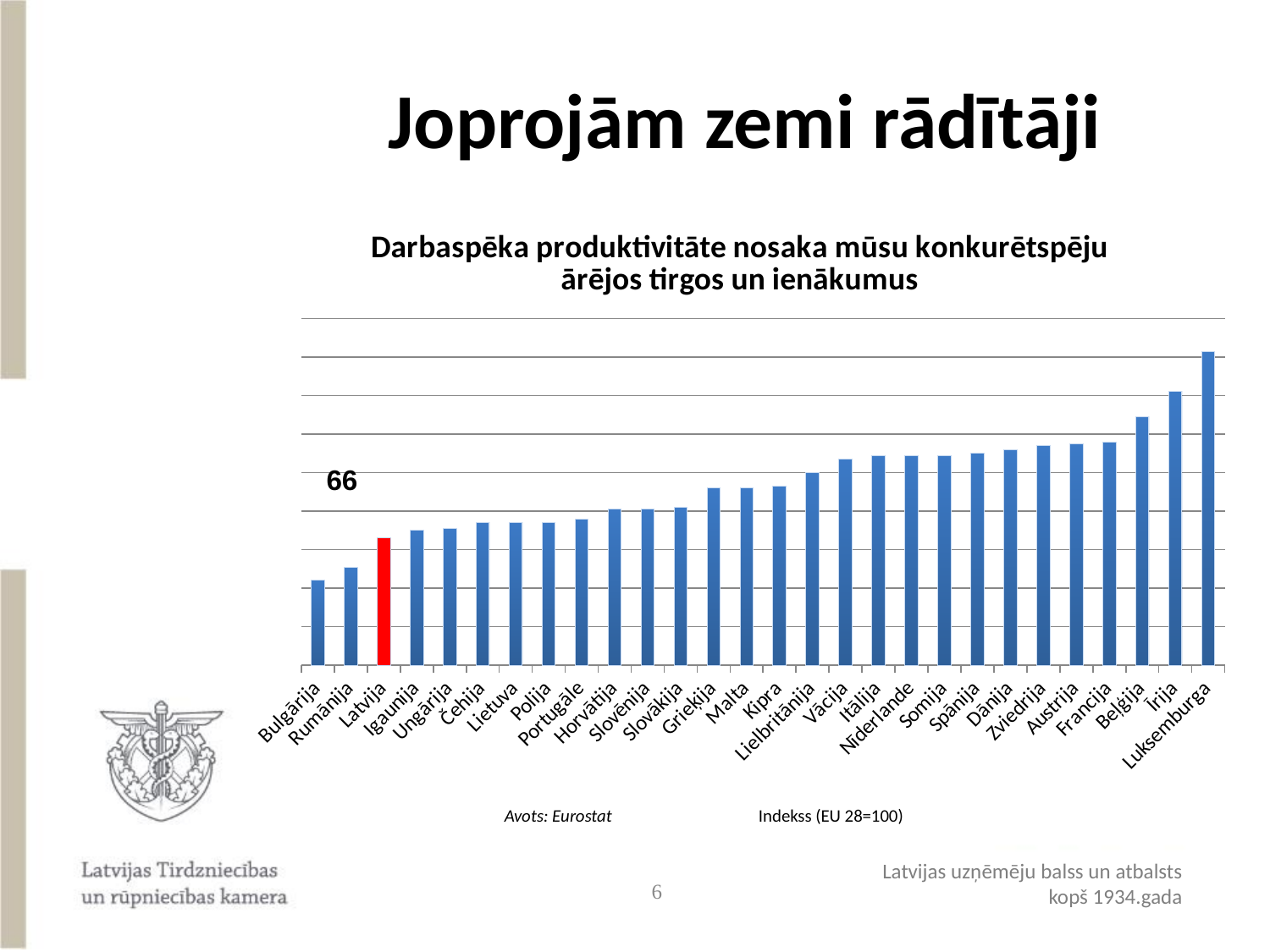
Which has the higher bar, Īrija or Beļģija? Īrija Which has the higher bar, Bulgārija or Rumānija? Rumānija What value is printed on the chart for Latvija, the highlighted red bar? 66 What kind of chart is shown on the slide? bar chart Which has the higher bar, Latvija or Igaunija? Igaunija What is the source of the data cited below the chart? Eurostat How many countries are shown on the x axis of the chart? 28 Which country's bar is highlighted in red? Latvija Which country has the lowest bar in the chart? Bulgārija Do the bar values rise or fall from left to right along the x axis? rise Which country has the highest bar in the chart? Luksemburga